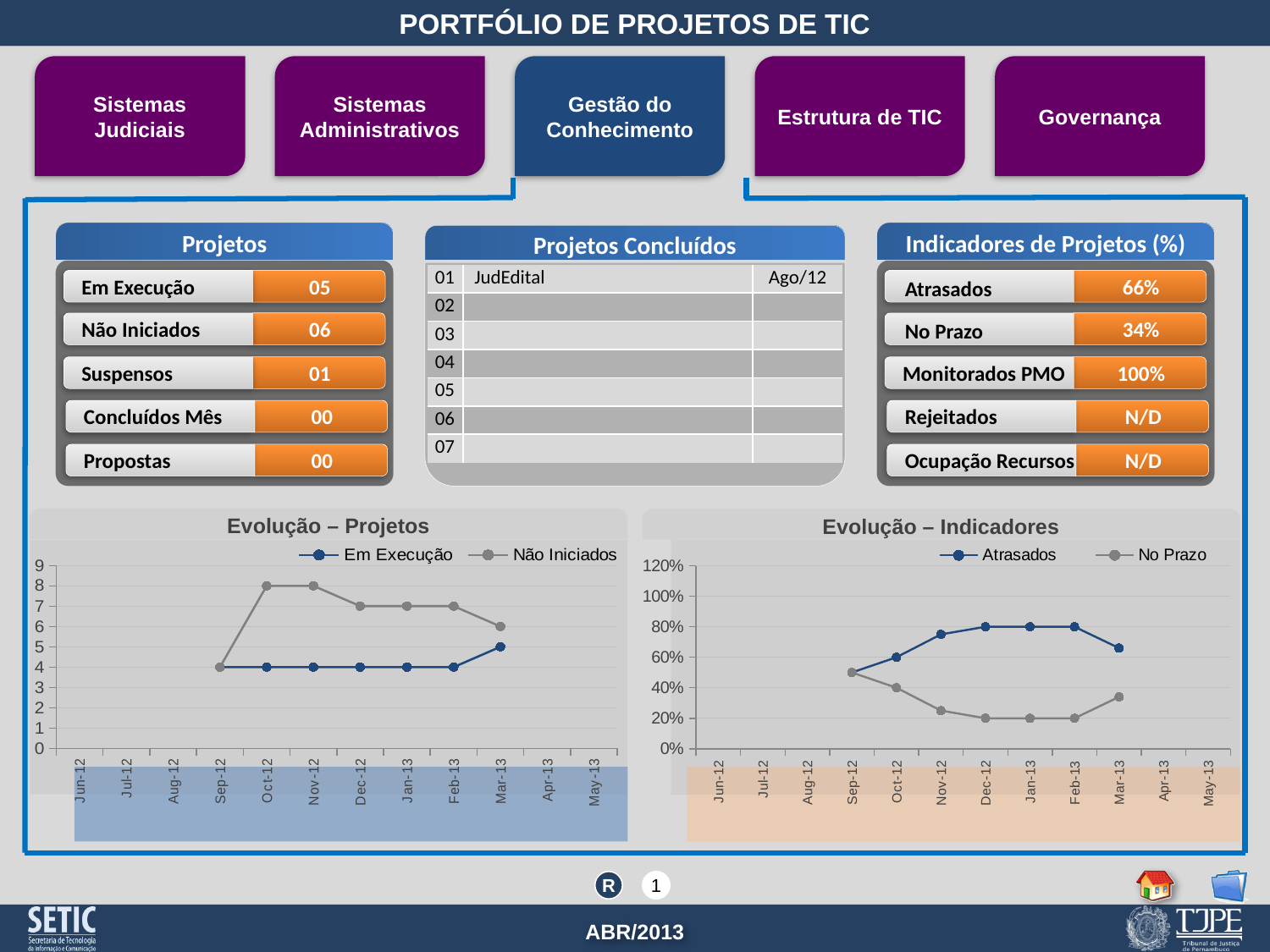
In the 'Evolução – Indicadores' chart, what is the value of Atrasados in Jan-13? 80% In the 'Evolução – Projetos' chart, what type of chart is shown? line chart In the 'Evolução – Projetos' chart, what is the value of Em Execução in Mar-13? 5 In the 'Evolução – Projetos' chart, in which month does Não Iniciados reach its highest value first? Oct-12 In the 'Evolução – Projetos' chart, how many series does the legend list? 2 In the 'Evolução – Indicadores' chart, is the value of No Prazo in Nov-12 greater or less than 40%? less In the 'Evolução – Projetos' chart, what is the difference between Não Iniciados and Em Execução in Dec-12? 3 In the 'Evolução – Indicadores' chart, which series is higher in Feb-13, Atrasados or No Prazo? Atrasados In the 'Evolução – Indicadores' chart, how many series does the legend list? 2 In the 'Evolução – Projetos' chart, what is the value of Não Iniciados in Mar-13? 6 In the 'Evolução – Projetos' chart, does Em Execução rise or fall from Feb-13 to Mar-13? rise In the 'Evolução – Projetos' chart, what is the value of Não Iniciados in Oct-12? 8